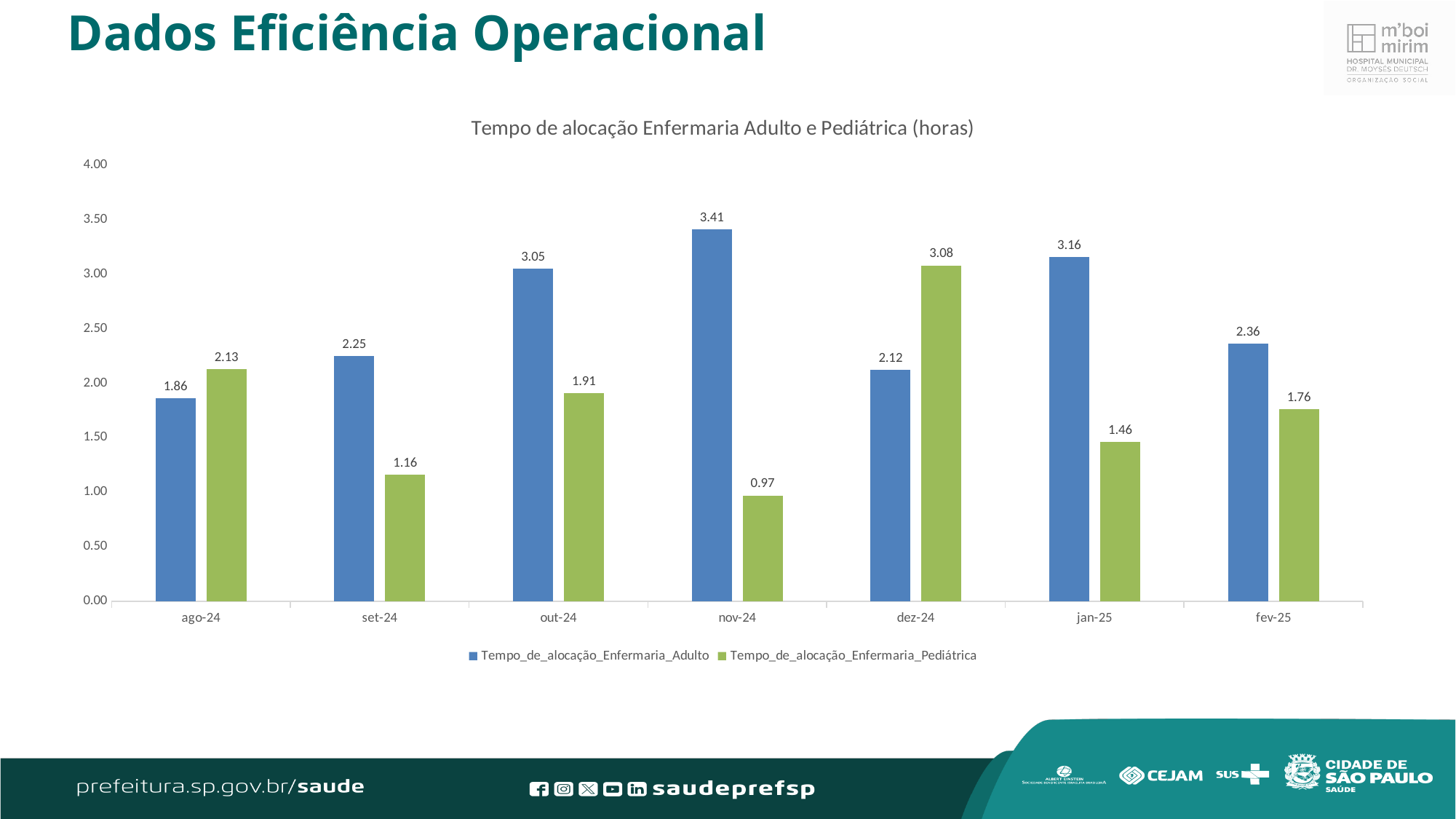
Is the value for Tempo_de_alocação_Enfermaria_Adulto in out-24 greater or less than 3.00? greater What is the value for Tempo_de_alocação_Enfermaria_Pediátrica in dez-24? 3.08 Which month has the lowest value for Tempo_de_alocação_Enfermaria_Pediátrica? nov-24 What is the value for Tempo_de_alocação_Enfermaria_Pediátrica in set-24? 1.16 What is the difference between the Adulto and Pediátrica values in nov-24? 2.44 Which month has the highest value for Tempo_de_alocação_Enfermaria_Adulto? nov-24 What kind of chart is shown on the slide? bar chart How many months are shown on the x axis? 7 How many series does the legend list? 2 Which is larger in dez-24, the Adulto value or the Pediátrica value? Pediátrica What is the value for Tempo_de_alocação_Enfermaria_Adulto in nov-24? 3.41 What is the title of the chart? Tempo de alocação Enfermaria Adulto e Pediátrica (horas)